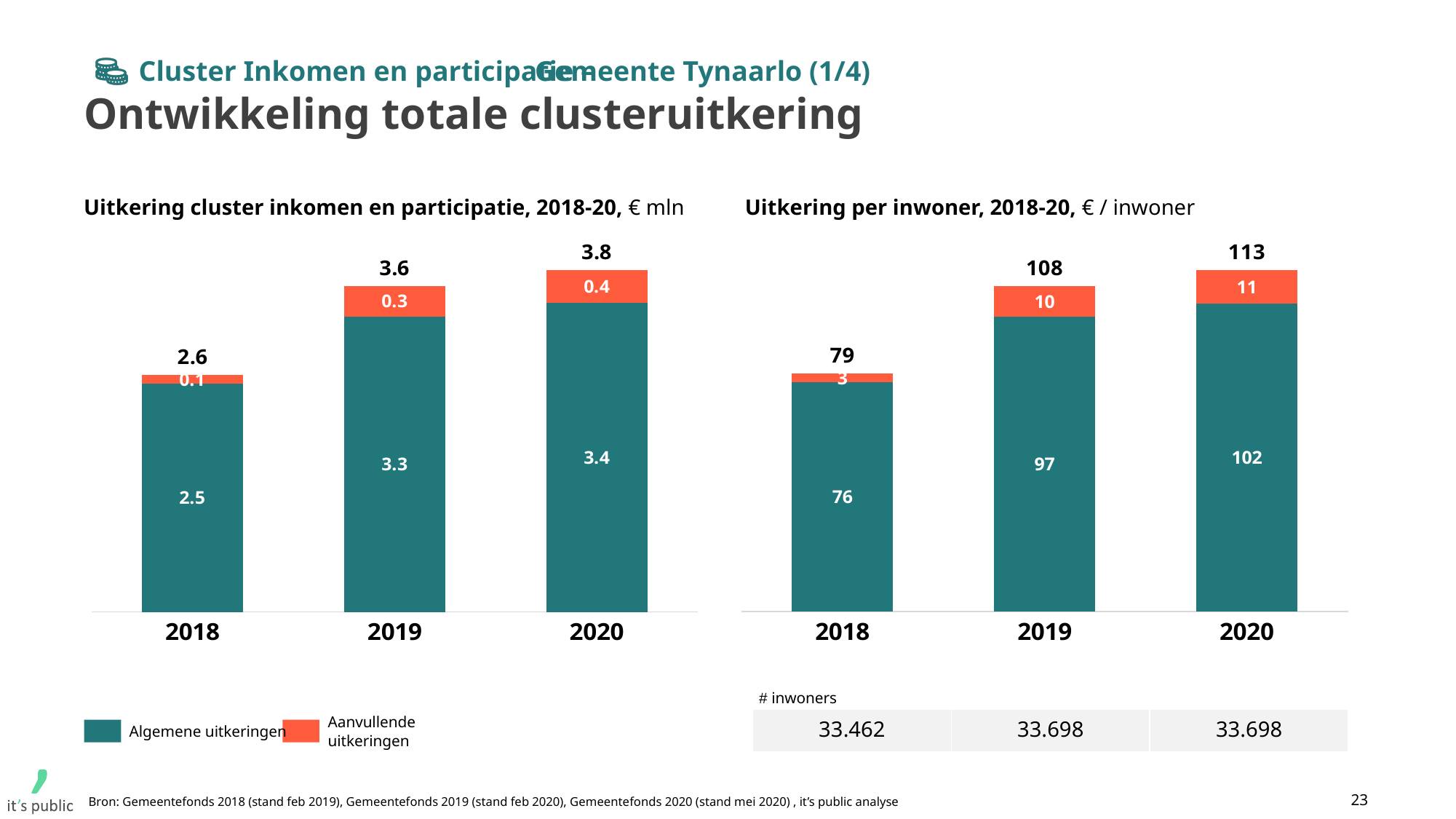
In the right chart (Uitkering per inwoner), which year has the lowest total? 2018 In the left chart (Uitkering cluster inkomen en participatie), what is the value of Algemene uitkeringen in 2019? 3.3 In the right chart (Uitkering per inwoner), what is the total of the stacked bar for 2019? 108 How many series does the legend list for the charts on this slide? 2 In the left chart (Uitkering cluster inkomen en participatie), what is the difference between the totals for 2020 and 2018? 1.2 In the left chart (Uitkering cluster inkomen en participatie), what is the total of the stacked bar for 2018? 2.6 In the right chart (Uitkering per inwoner), what is the difference between the totals for 2020 and 2019? 5 In the right chart (Uitkering per inwoner), what is the value of Aanvullende uitkeringen in 2019? 10 In the right chart (Uitkering per inwoner), what is the value of Algemene uitkeringen in 2020? 102 In the left chart (Uitkering cluster inkomen en participatie), which year has the highest total? 2020 In the right chart (Uitkering per inwoner), do the totals rise or fall from 2018 to 2020? rise In the left chart (Uitkering cluster inkomen en participatie), what is the value of Aanvullende uitkeringen in 2020? 0.4